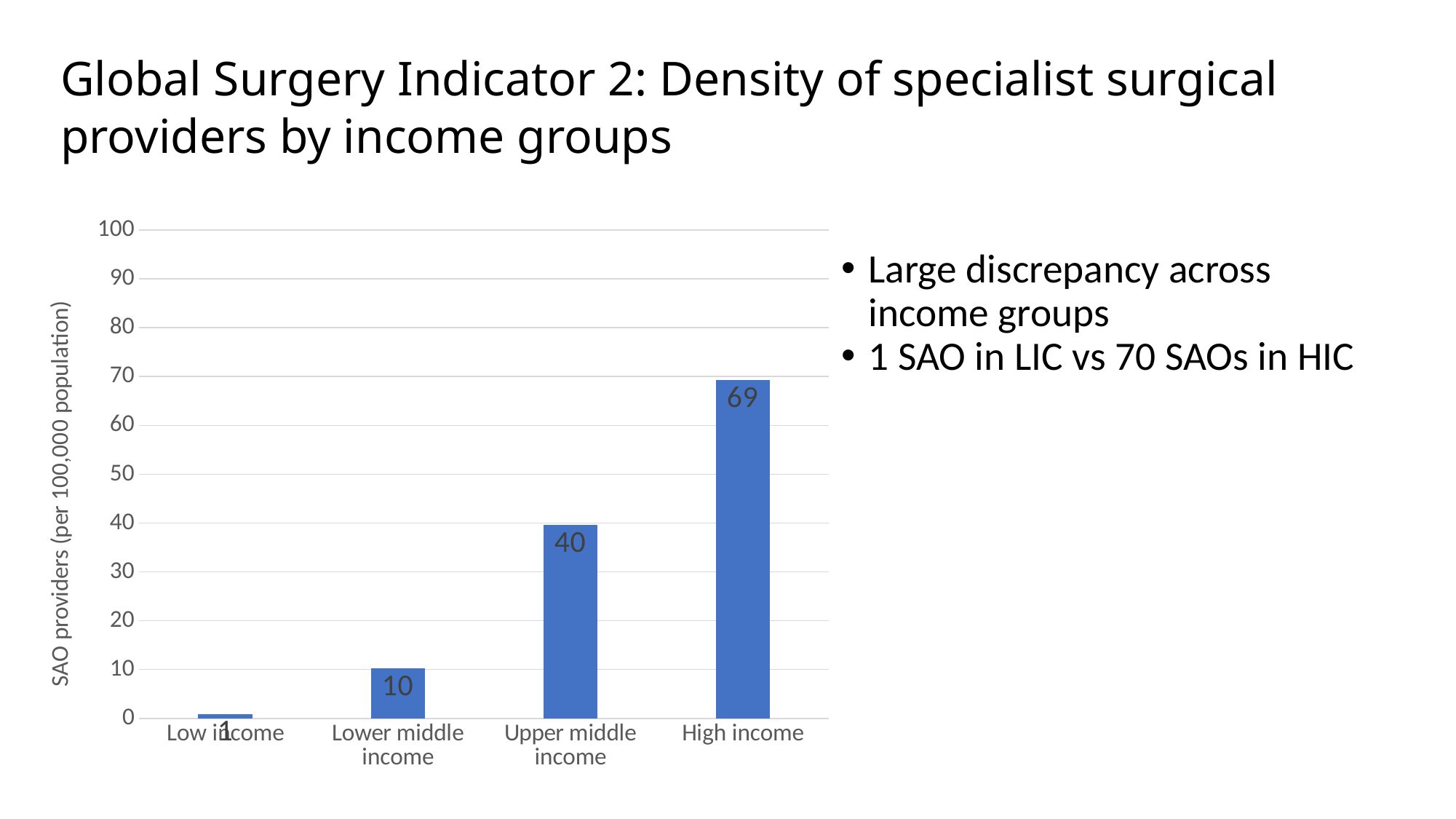
How many income groups are shown on the chart? 4 Do the values rise or fall from Low income to High income along the x axis? Rise What is the value for Lower middle income? 10 Which income group has the lowest number of SAO providers per 100,000 population? Low income What kind of chart is shown on the slide? Bar chart What is the value for Upper middle income? 40 What is the difference between the values for Lower middle income and Low income? 9 Which is larger, the value for Upper middle income or Lower middle income? Upper middle income What is the difference between the values for High income and Upper middle income? 29 Which income group has the highest number of SAO providers per 100,000 population? High income What is the value for High income? 69 What is the value for Low income? 1